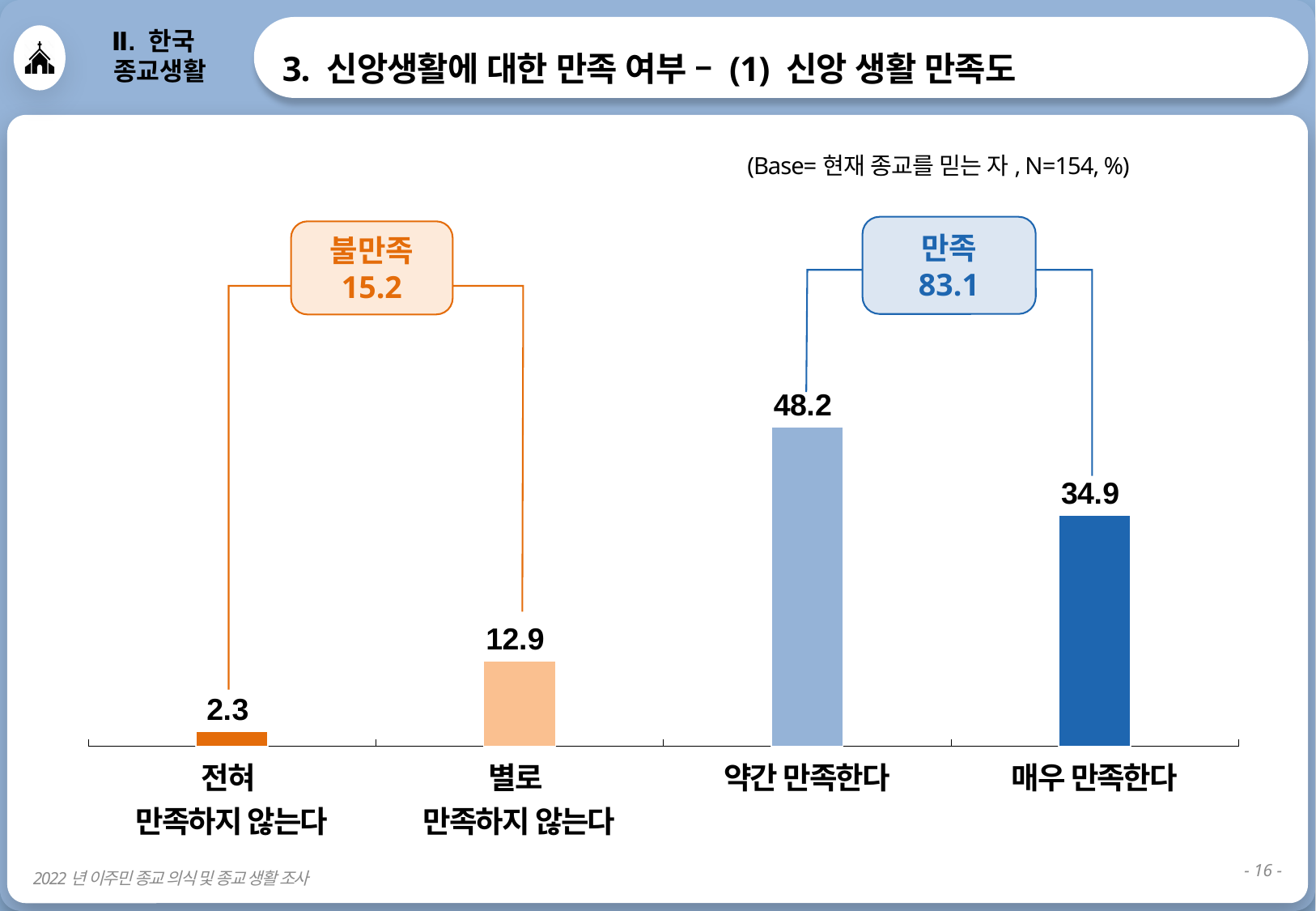
What is the value for 매우 만족한다? 34.9 What is the value for 전혀 만족하지 않는다? 2.3 What is the value for 별로 만족하지 않는다? 12.9 Which category has the lowest value? 전혀 만족하지 않는다 How many categories are shown on the x axis? 4 What is the value for 약간 만족한다? 48.2 What combined value is shown in the 만족 box above the chart? 83.1 Which category has the highest value? 약간 만족한다 What is the difference between the values for 약간 만족한다 and 매우 만족한다? 13.3 Which is larger, the value for 별로 만족하지 않는다 or the value for 매우 만족한다? 매우 만족한다 What combined value is shown in the 불만족 box above the chart? 15.2 What kind of chart is shown on the slide? bar chart